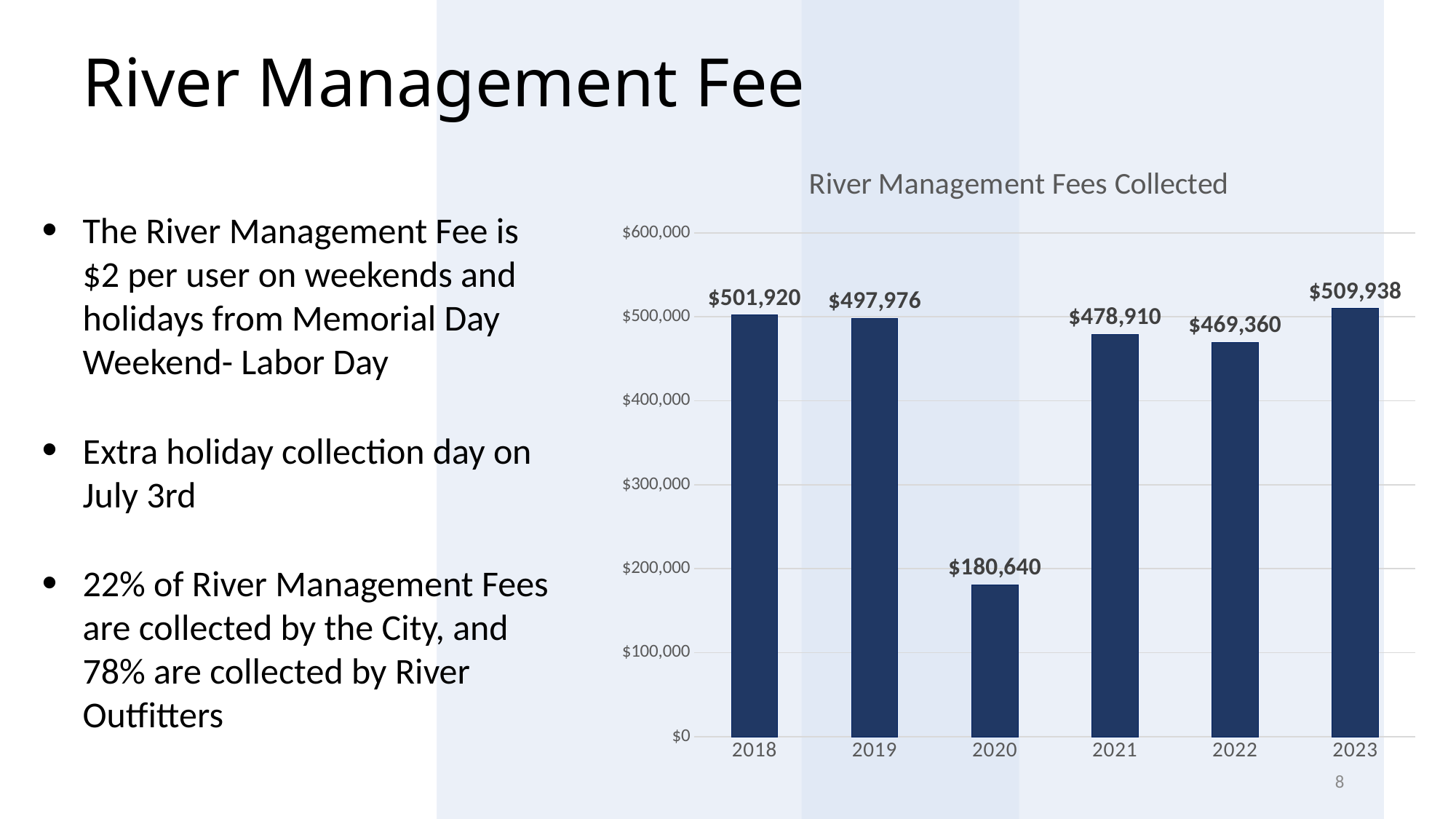
What is the title of the chart on the slide? River Management Fees Collected How many years are shown on the x axis of the chart? 6 Which year had higher fees collected, 2021 or 2022? 2021 What value is shown for 2018 in the River Management Fees Collected chart? $501,920 What value is shown for 2022 in the River Management Fees Collected chart? $469,360 What is the difference between the fees collected in 2018 and 2019? $3,944 What value is shown for 2020 in the River Management Fees Collected chart? $180,640 What is the difference between the fees collected in 2023 and 2022? $40,578 Is the value for 2020 greater or less than $200,000? less Which year has the highest fees collected in the chart? 2023 Which year has the lowest fees collected in the chart? 2020 What kind of chart is shown on the slide? bar chart